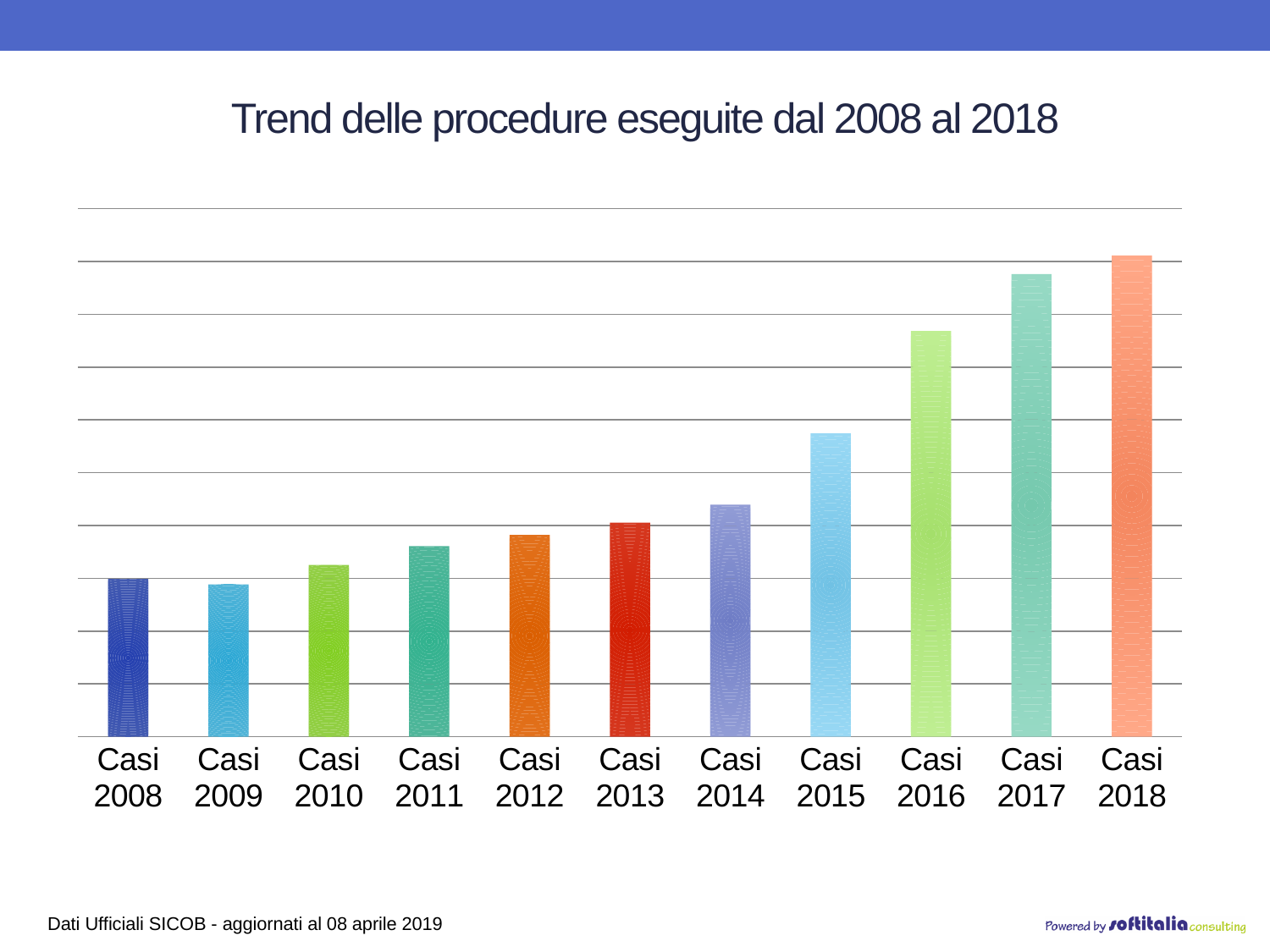
Which is larger, the value for Casi 2017 or Casi 2016? Casi 2017 How many categories (years) are plotted on the x axis? 11 Do the values generally rise or fall from Casi 2009 to Casi 2018? rise Which is larger, the value for Casi 2016 or Casi 2013? Casi 2016 What kind of chart is shown on the slide? bar chart Which is larger, the value for Casi 2015 or Casi 2014? Casi 2015 Which category has the second-highest bar? Casi 2017 Which category has the highest bar? Casi 2018 What is the title of the chart? Trend delle procedure eseguite dal 2008 al 2018 What data source is cited at the bottom of the slide? Dati Ufficiali SICOB - aggiornati al 08 aprile 2019